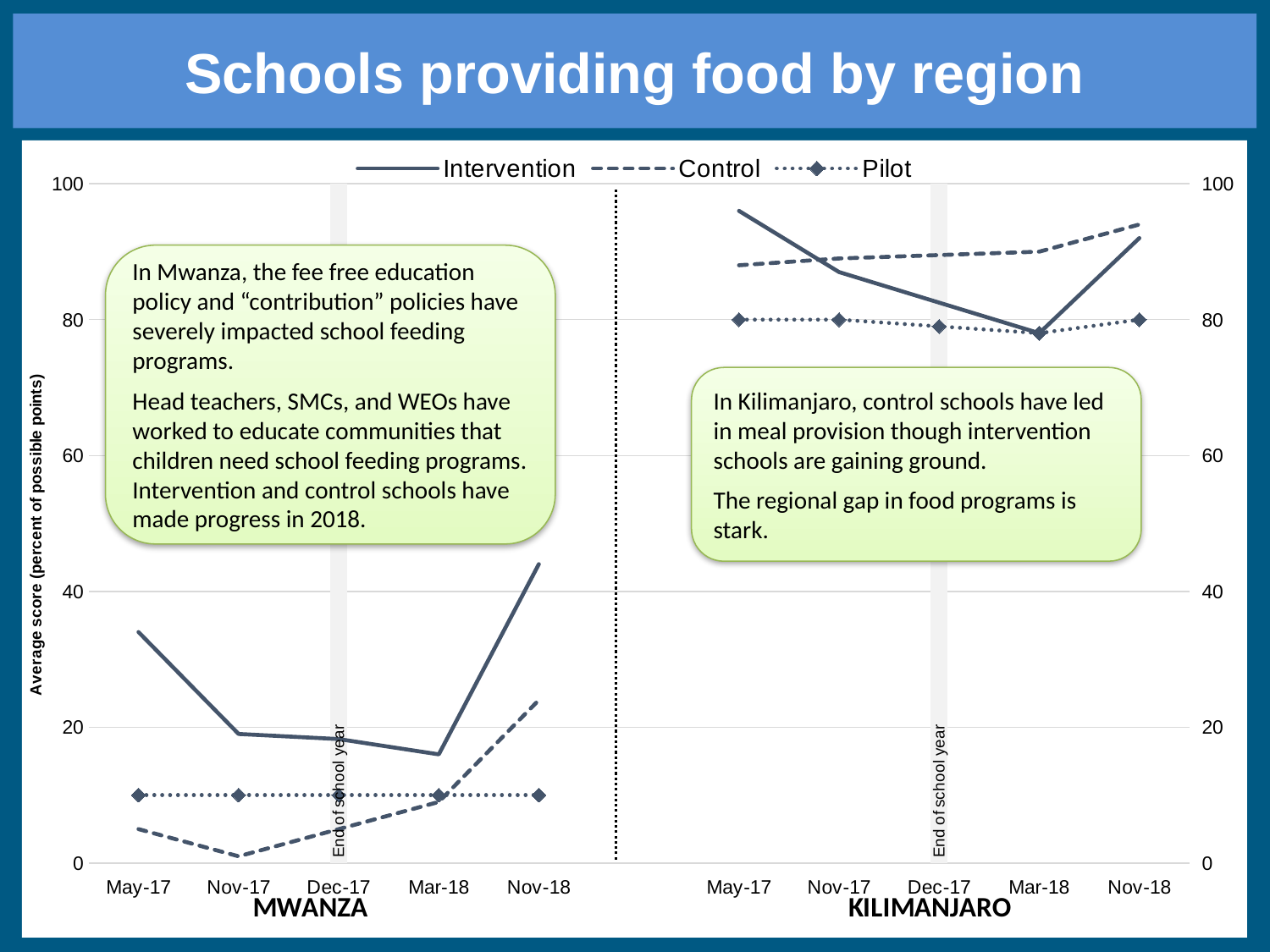
In the KILIMANJARO panel, is the Intervention value at May-17 greater or less than 80? greater In the MWANZA panel, which series has the highest value at May-17? Intervention What kind of chart is shown on the slide? line chart In the MWANZA panel, is the Control value at Nov-17 greater or less than 20? less In the KILIMANJARO panel, which series has the lowest value at May-17? Pilot How many series does the legend list? 3 In the MWANZA panel, does the Control series rise or fall from Nov-17 to Nov-18? rise In the MWANZA panel, is the Intervention value at May-17 greater or less than 20? greater What are the three series named in the legend? Intervention, Control, Pilot How many time points are plotted on the x axis of the MWANZA panel? 5 In the MWANZA panel at Nov-18, which is larger, the Intervention value or the Control value? Intervention